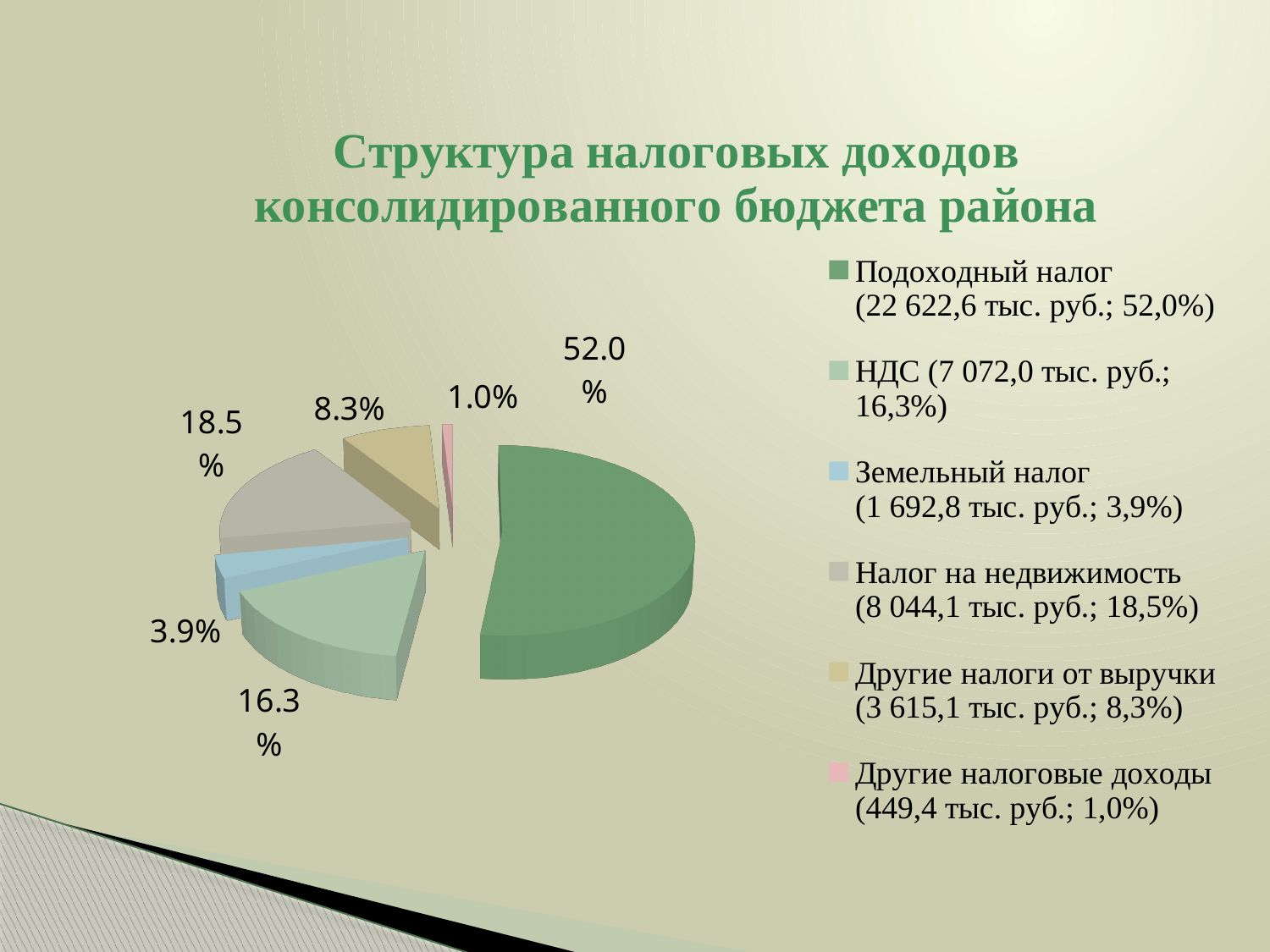
What is the difference in percentage points between the Подоходный налог slice and the Налог на недвижимость slice? 33.5 What share of the pie does Подоходный налог account for? 52.0% According to the legend, what amount in thousand rubles corresponds to НДС? 7 072,0 тыс. руб. Which is larger: the slice for Налог на недвижимость or the slice for НДС? Налог на недвижимость What share of the pie does НДС account for? 16.3% Which category has the smallest slice of the pie? Другие налоговые доходы Which category has the largest slice of the pie? Подоходный налог What share of the pie does Земельный налог account for? 3.9% How many slices does the pie chart have? 6 What is the title of the chart on the slide? Структура налоговых доходов консолидированного бюджета района What kind of chart is shown on the slide? pie chart